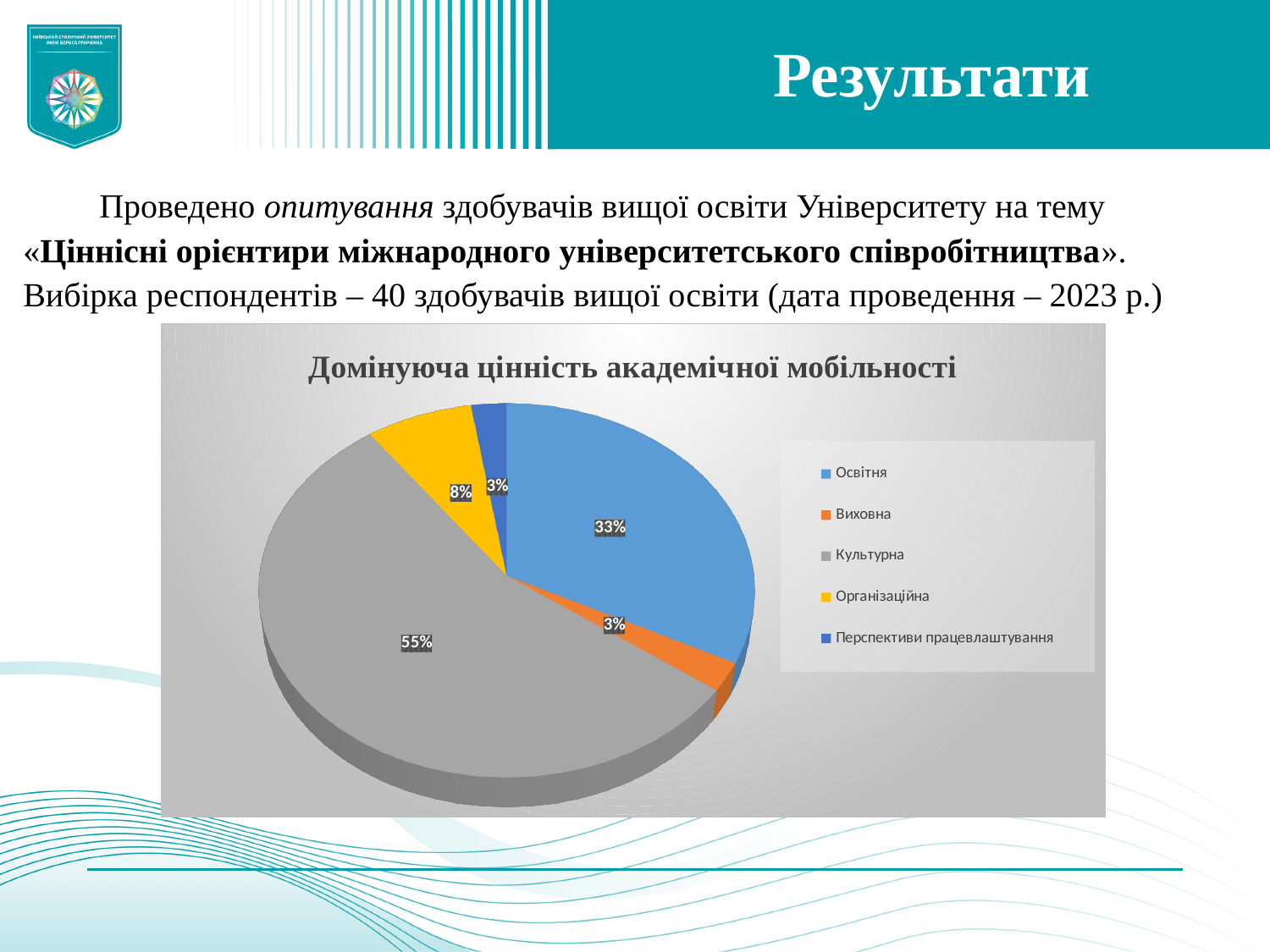
What share of the pie does Організаційна have? 8% What share of the pie does Освітня have? 33% What share of the pie does Культурна have? 55% Which is larger, the share for Освітня or the share for Організаційна? Освітня Which colour represents Організаційна in the pie chart? yellow What is the title of the chart? Домінуюча цінність академічної мобільності Which category has the largest slice of the pie? Культурна How many categories does the legend of the pie chart list? 5 What is the difference in percentage points between Культурна and Освітня? 22 What is the combined share of Культурна and Освітня? 88% What kind of chart is shown on the slide? pie chart